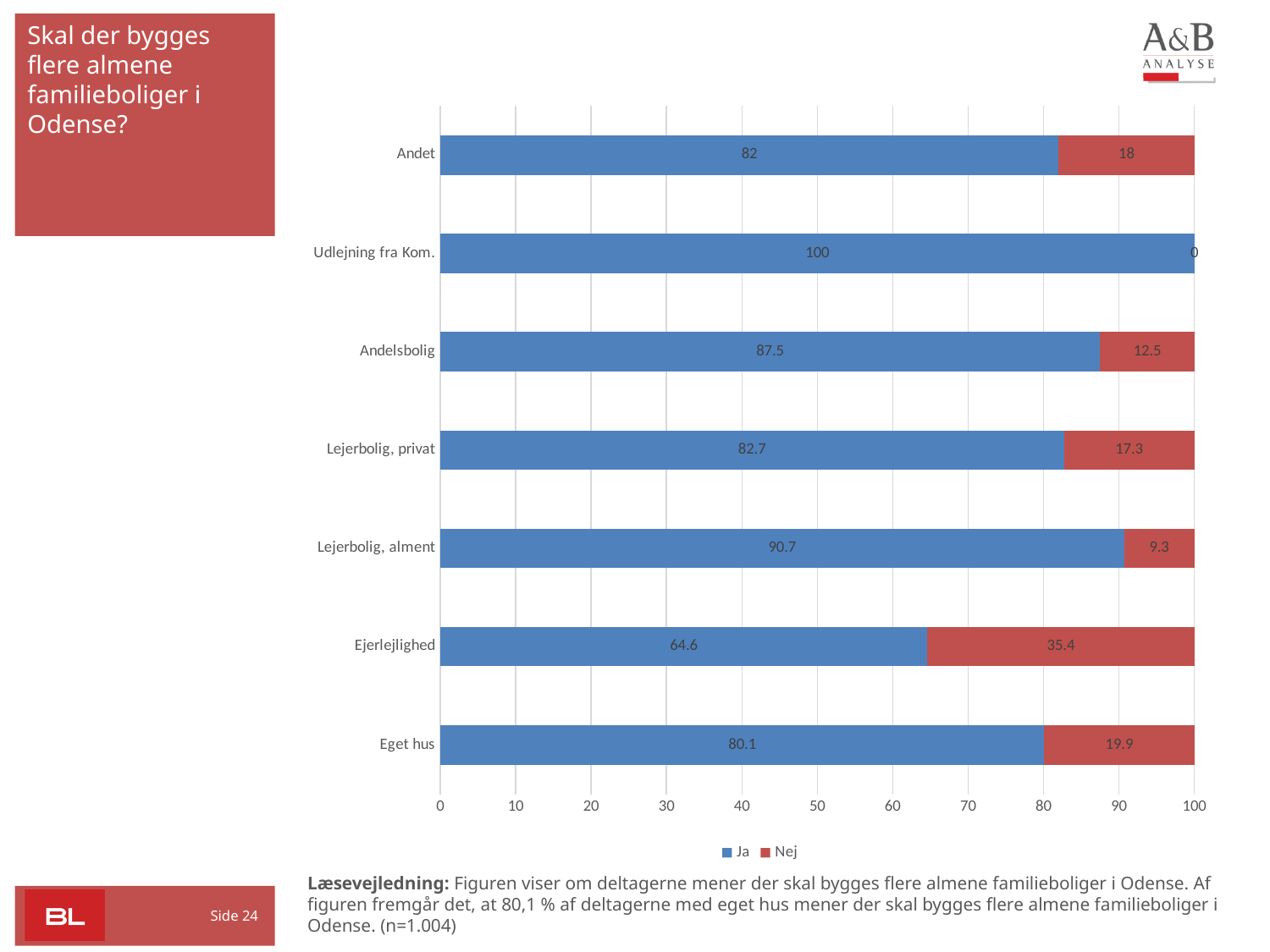
What is the "Nej" value for Andelsbolig? 12.5 How many categories are shown on the chart? 7 How many series does the legend list? 2 What is the "Nej" value for Ejerlejlighed? 35.4 What is the total of the stacked bar for Lejerbolig, privat? 100 What is the "Ja" value for Lejerbolig, alment? 90.7 Which category has the lowest "Ja" value? Ejerlejlighed What kind of chart is shown on the slide? Stacked bar chart What is the difference between the "Nej" values for Ejerlejlighed and Eget hus? 15.5 What is the "Ja" value for Eget hus? 80.1 Which category has the highest "Ja" value? Udlejning fra Kom. Which has a larger "Ja" value, Andet or Lejerbolig, privat? Lejerbolig, privat